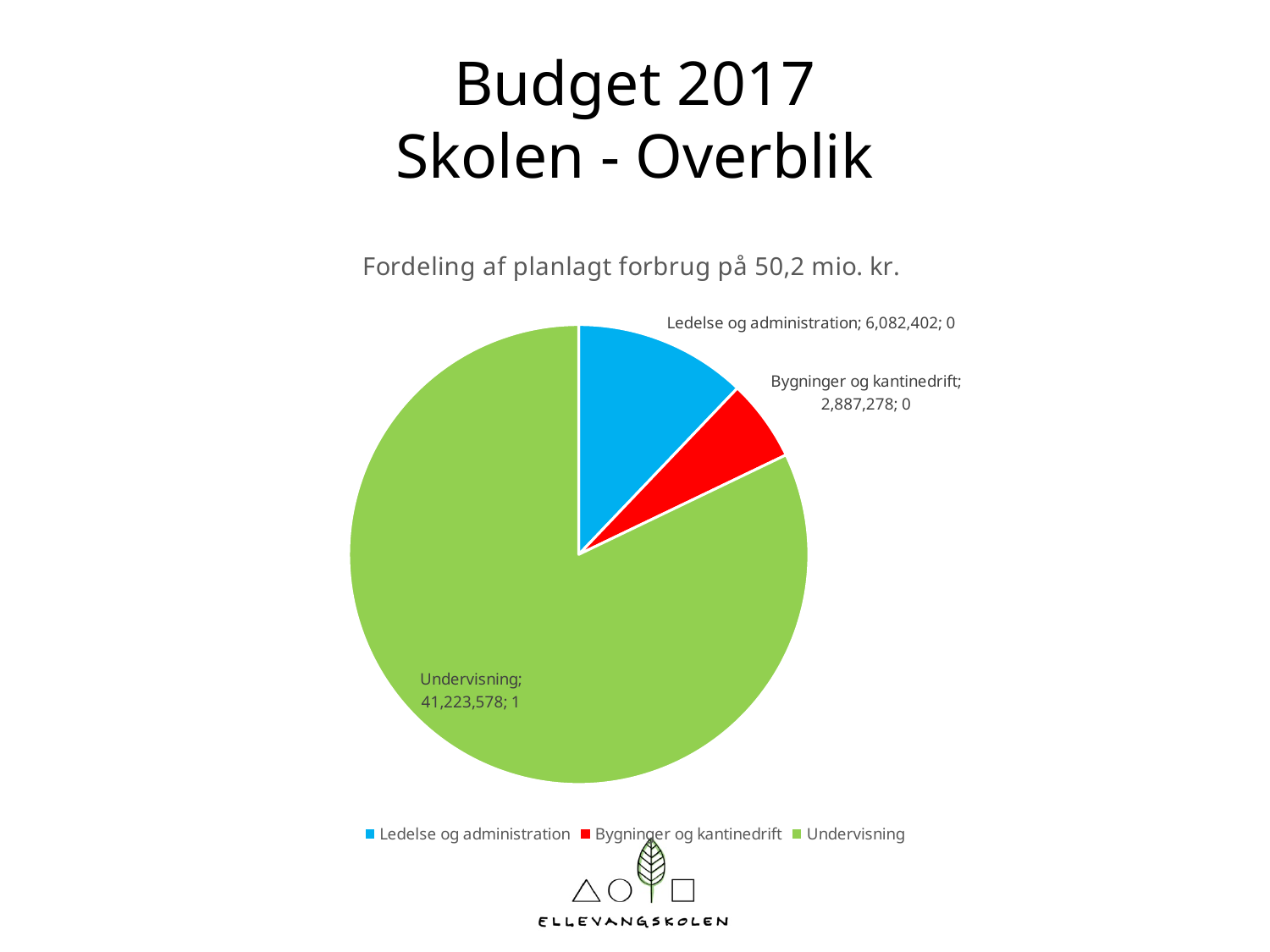
What is the value for Undervisning? 41,223,578 What is the difference between the values for Undervisning and Ledelse og administration? 35,141,176 How many categories are shown in the pie chart? 3 What is the value for Ledelse og administration? 6,082,402 Which is larger, the value for Ledelse og administration or the value for Bygninger og kantinedrift? Ledelse og administration What is the difference between the values for Ledelse og administration and Bygninger og kantinedrift? 3,195,124 What kind of chart is shown on the slide? Pie chart What is the title of the chart? Fordeling af planlagt forbrug på 50,2 mio. kr. Which category has the largest slice of the pie? Undervisning Which colour represents Undervisning in the pie chart? Green What is the value for Bygninger og kantinedrift? 2,887,278 Which category has the smallest slice of the pie? Bygninger og kantinedrift